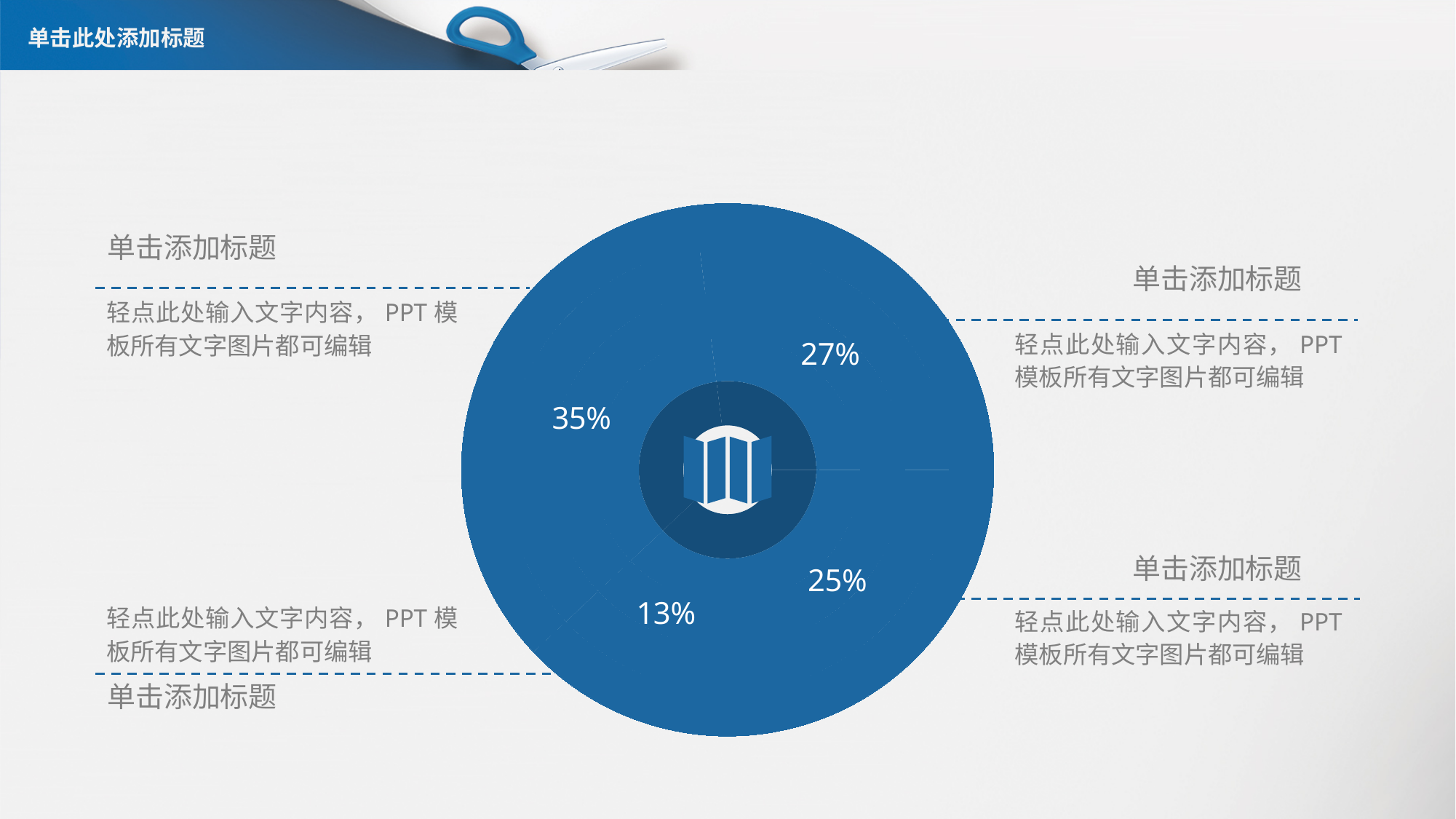
What is the value of the slice at the bottom of the pie chart? 13% What do the four percentage labels on the pie chart add up to? 100% What is the value of the slice on the left side of the pie chart? 35% What is the value of the upper-right slice of the pie chart? 27% What kind of chart is shown on the slide? pie chart How many slices does the pie chart have? 4 What is the largest percentage shown on the pie chart? 35% What colour are the slices of the pie chart? blue What is the difference between the largest and smallest slice values on the pie chart? 22% What is the value of the lower-right slice of the pie chart? 25% What is the smallest percentage shown on the pie chart? 13% Which is larger, the upper-right slice or the lower-right slice of the pie chart? the upper-right slice (27%)